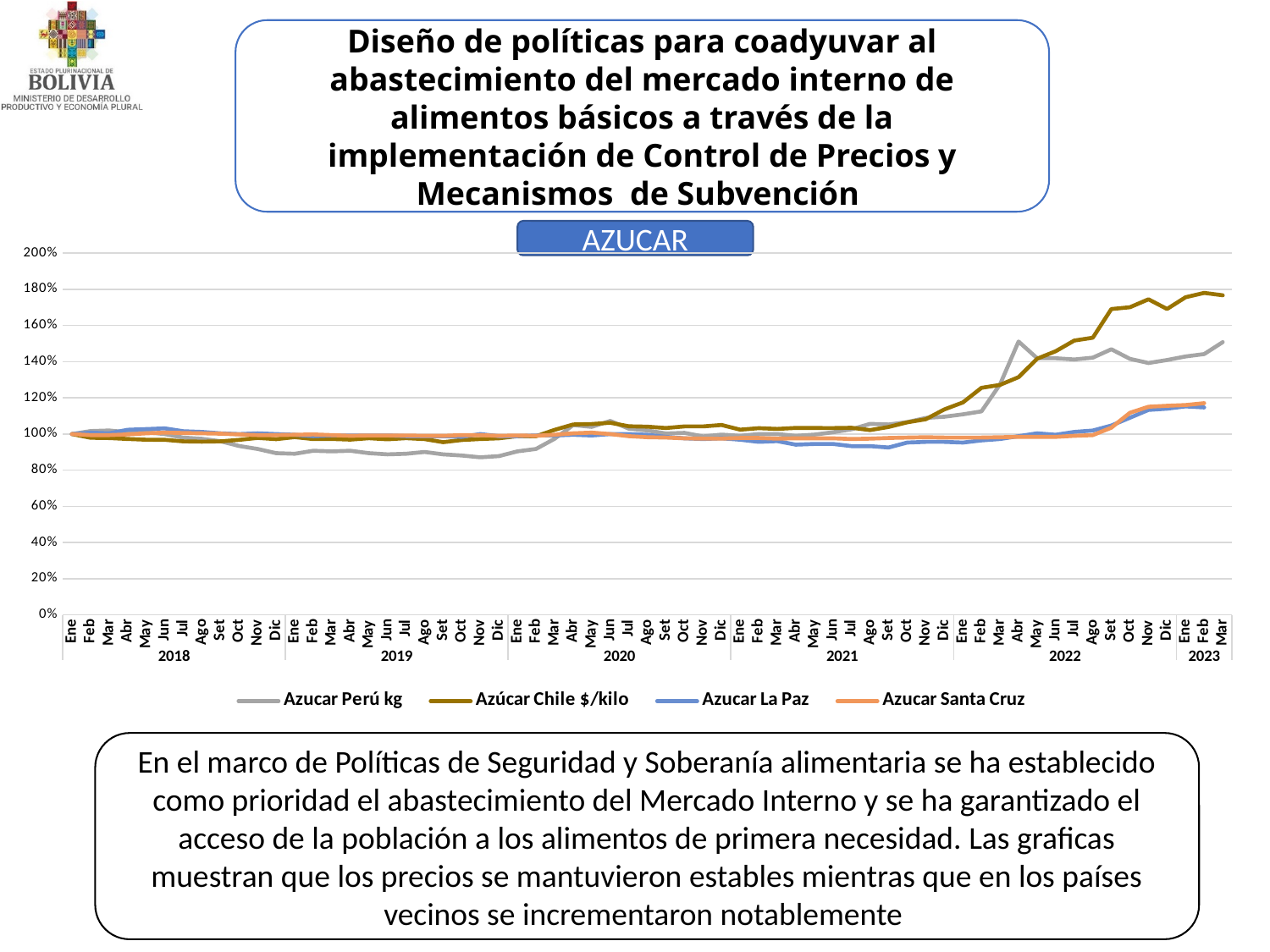
How many series does the legend list? 4 How many years are labelled on the x axis? 6 Which series has the highest value at Mar 2023? Azúcar Chile $/kilo Is the value for Azúcar Chile $/kilo at Mar 2023 greater or less than 160%? greater What is the title shown above the chart? AZUCAR What kind of chart is shown on the slide? line chart Which series is drawn in grey? Azucar Perú kg Is the value for Azucar Perú kg at Nov 2019 greater or less than 100%? less Does the Azúcar Chile $/kilo series rise or fall from Jan 2021 to Mar 2023? rise Is the value for Azucar Perú kg at Mar 2023 greater or less than 140%? greater